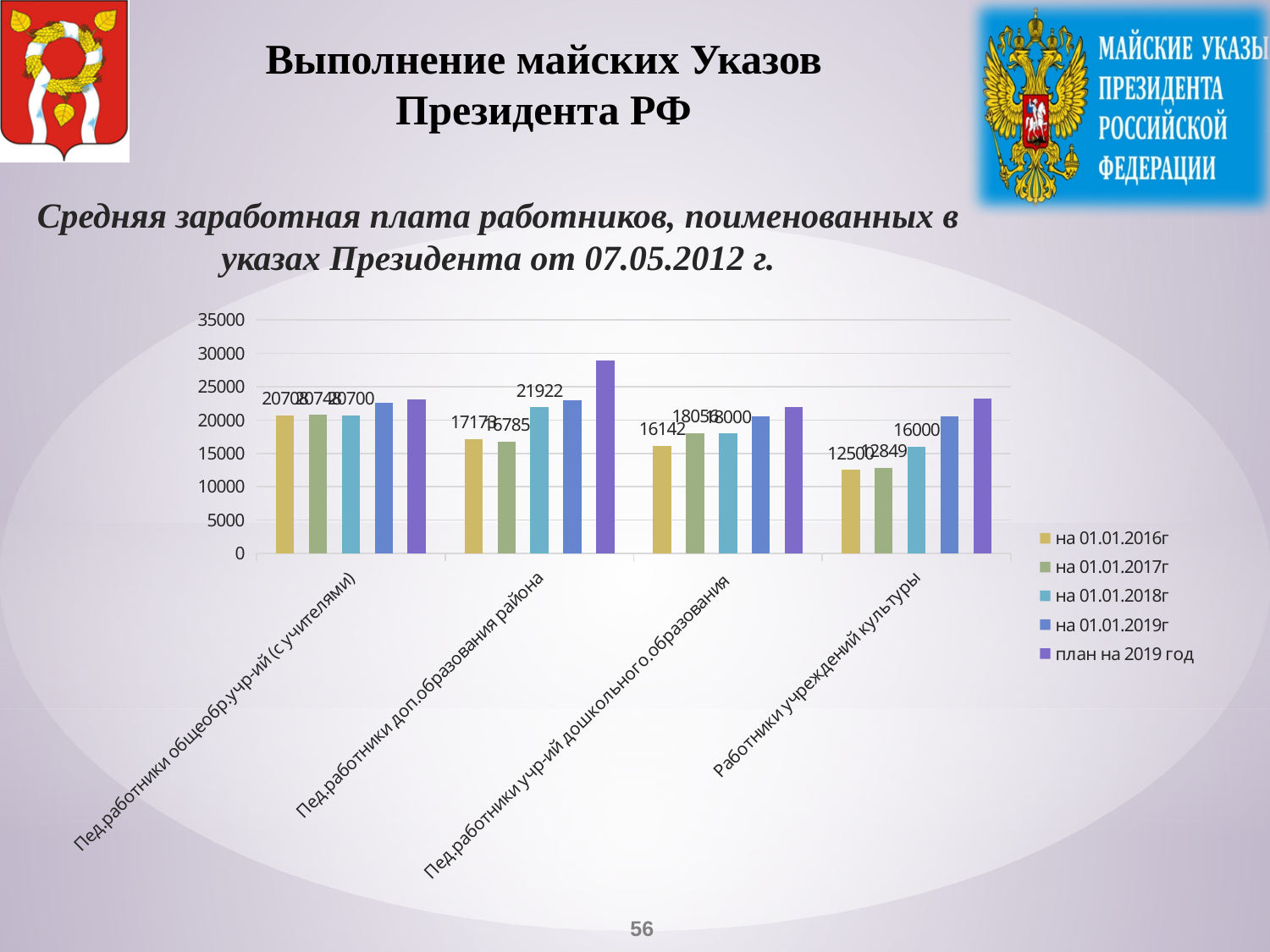
What is the value for Пед.работники учр-ий дошкольного образования in the series на 01.01.2016г? 16142 What is the last entry in the chart legend? план на 2019 год Is the план на 2019 год value for Пед.работники доп.образования района greater or less than 25000? greater How many categories are shown on the x axis? 4 What is the value for Работники учреждений культуры in the series на 01.01.2016г? 12500 For Пед.работники доп.образования района, which is larger: the value for на 01.01.2016г or на 01.01.2017г? на 01.01.2016г Which category has the lowest value in the series на 01.01.2016г? Работники учреждений культуры How many series does the legend list? 5 What is the value for Пед.работники доп.образования района in the series на 01.01.2018г? 21922 What is the value for Работники учреждений культуры in the series на 01.01.2018г? 16000 What kind of chart is shown on the slide? bar chart What is the difference between the на 01.01.2018г and на 01.01.2017г values for Пед.работники доп.образования района? 5137